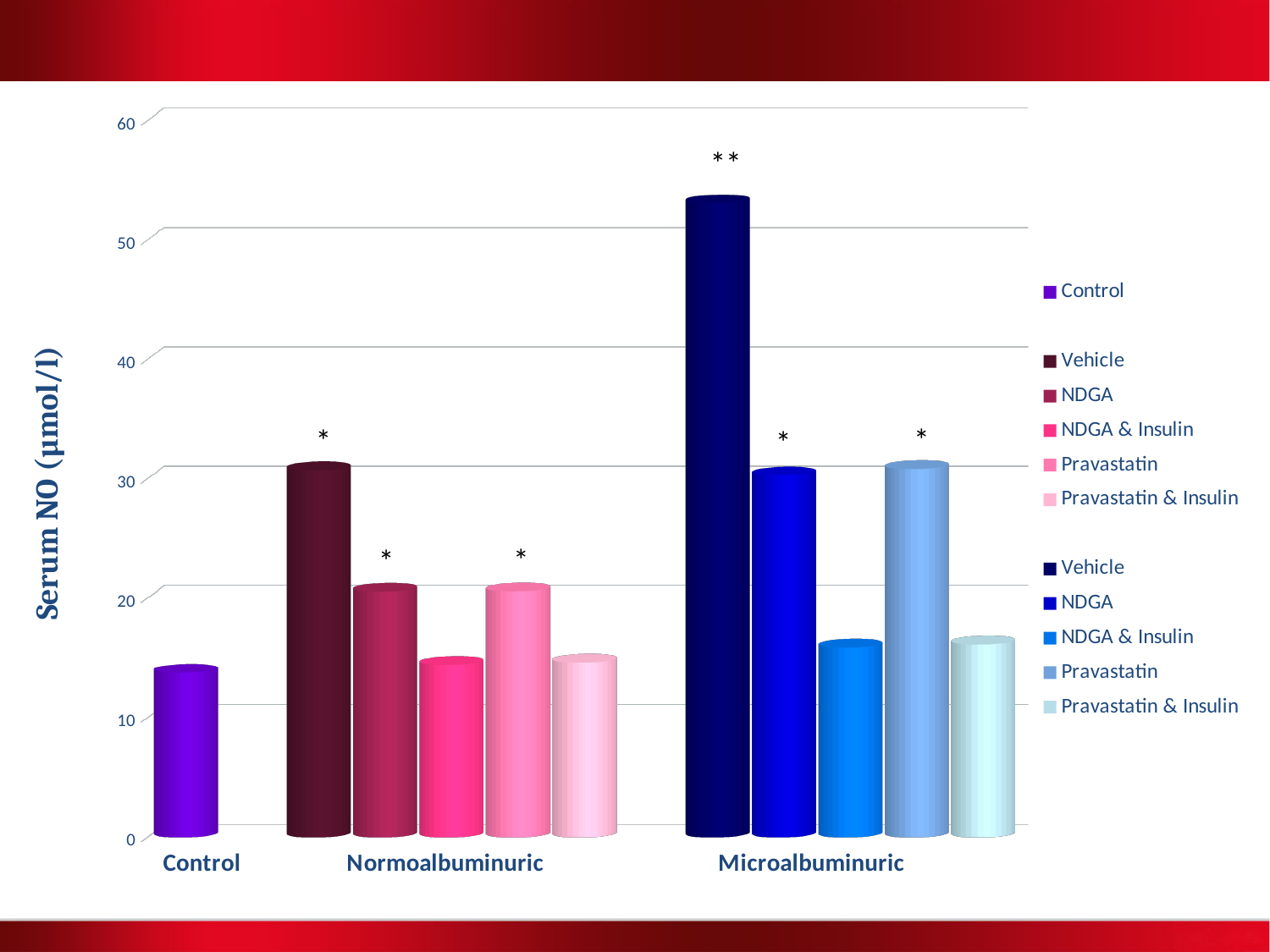
What kind of chart is shown on the slide? bar chart How many groups are labelled along the x axis? 3 In the Normoalbuminuric group, which is larger: NDGA or NDGA & Insulin? NDGA Which is larger: the Vehicle bar in the Normoalbuminuric group or the Vehicle bar in the Microalbuminuric group? Vehicle in the Microalbuminuric group Is the value for NDGA & Insulin in the Microalbuminuric group greater or less than 20? less Which bar is the highest in the chart? Vehicle in the Microalbuminuric group Is the value for Control greater or less than 20? less Is the value for Vehicle in the Microalbuminuric group greater or less than 50? greater What is the label on the y axis? Serum NO (µmol/l) Which bar is marked with two asterisks? Vehicle in the Microalbuminuric group How many entries does the legend list? 11